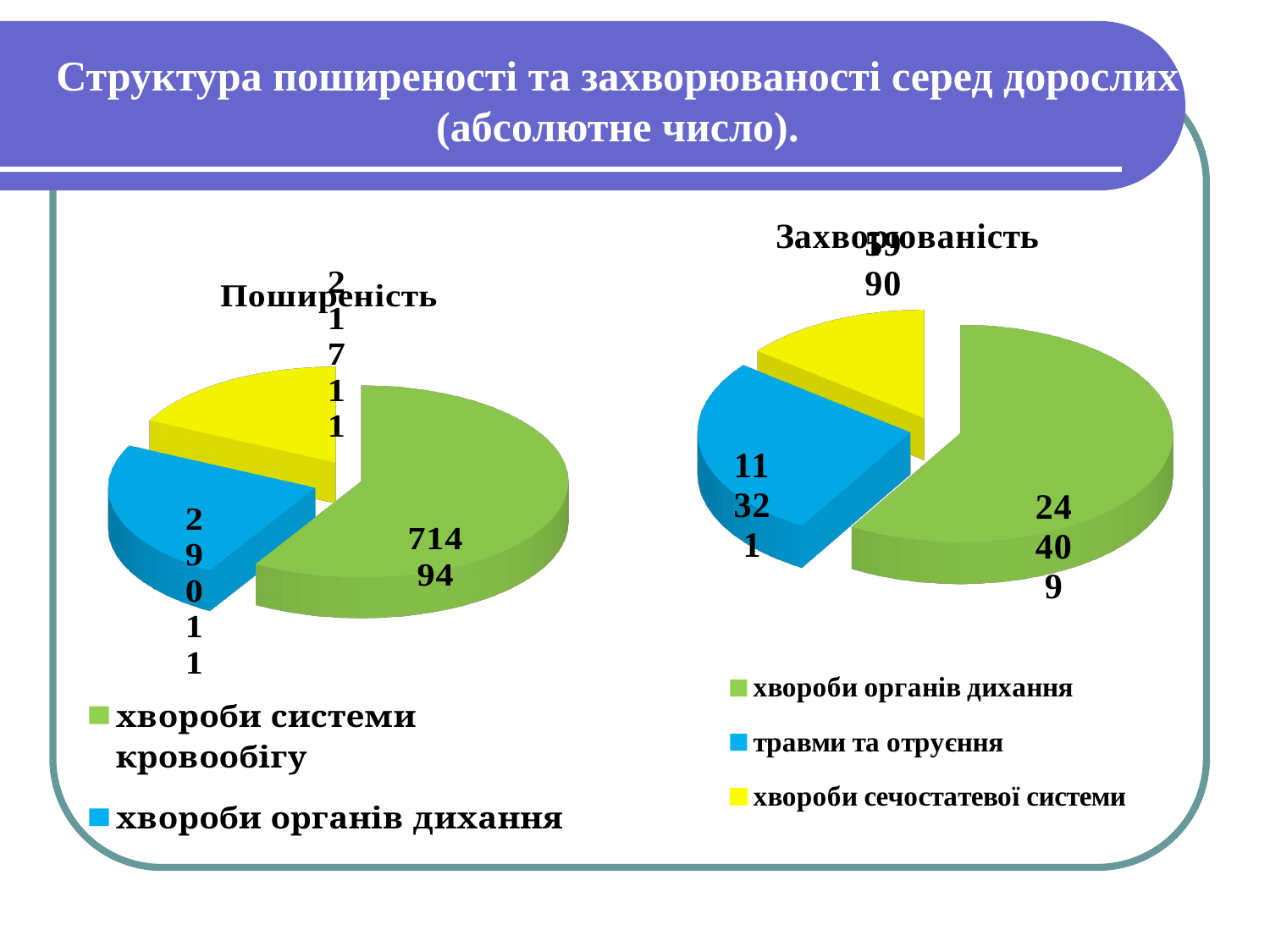
How many entries does the legend of the Захворюваність chart list? 3 In the Захворюваність chart, what is the difference between хвороби органів дихання and травми та отруєння? 13088 In the Захворюваність chart, which category has the largest slice? хвороби органів дихання What kind of charts are shown on the slide? Pie charts In the Захворюваність chart, what is the value for хвороби органів дихання? 24409 In the Поширеність chart, which category has the largest slice? хвороби системи кровообігу In the Поширеність chart, how many slices does the pie have? 3 In the Захворюваність chart, what is the value for травми та отруєння? 11321 In the Поширеність chart, what is the difference between хвороби системи кровообігу and хвороби органів дихання? 42483 In the Поширеність chart, what is the value for хвороби системи кровообігу? 71494 In the Захворюваність chart, which is larger: травми та отруєння or хвороби сечостатевої системи? травми та отруєння In the Поширеність chart, what is the value for хвороби органів дихання? 29011